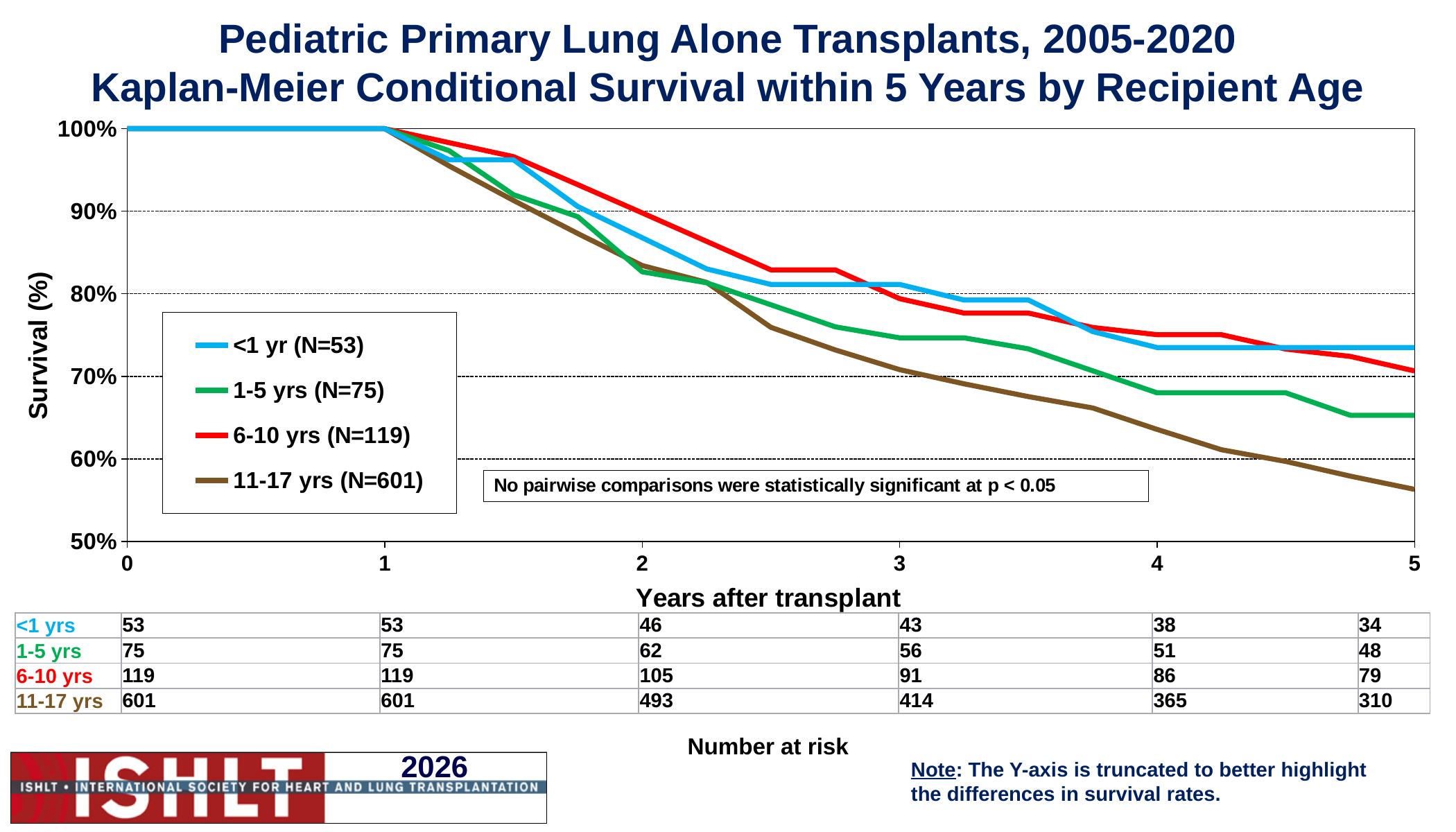
What is the sample size (N) for the 11-17 yrs group shown in the legend? 601 Do the survival curves rise or fall as years after transplant increase? fall What kind of chart is shown on the slide? Line chart In the number at risk table, which group has the fewest recipients at risk at year 5? <1 yrs Which recipient age group has the lowest survival at year 5? 11-17 yrs At year 4, which group has more recipients at risk: 1-5 yrs or <1 yrs? 1-5 yrs According to the number at risk table, how many 6-10 yrs recipients are at risk at year 3? 91 Is the survival for the 11-17 yrs group at year 5 greater or less than 60%? less Is the survival for the <1 yr group at year 5 greater or less than 70%? greater How many series does the legend list? 4 By how much does the number at risk for the 11-17 yrs group fall from year 0 to year 5? 291 According to the number at risk table, how many 11-17 yrs recipients are at risk at year 5? 310